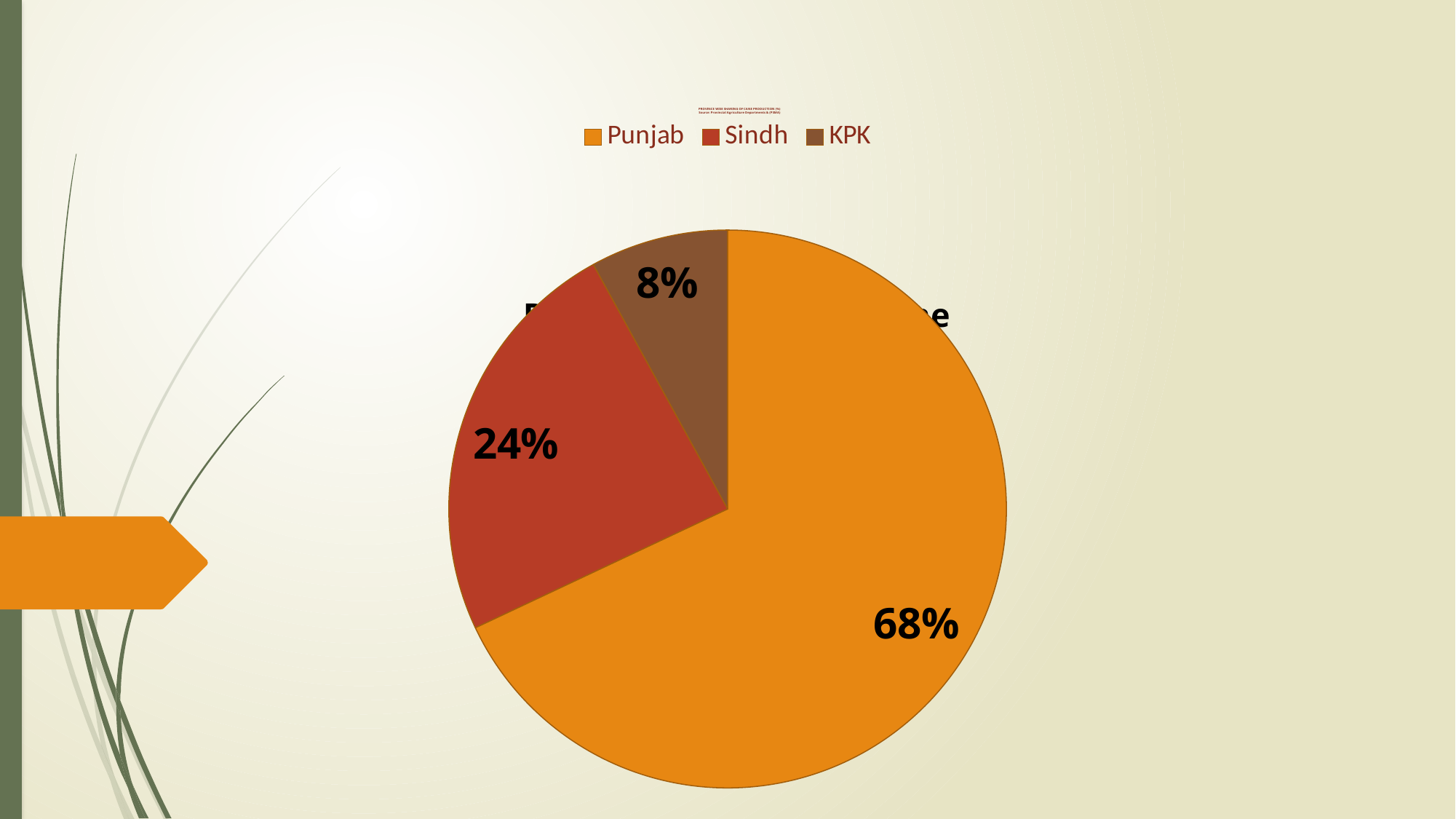
What is the difference in percentage points between Punjab's share and Sindh's share? 44 What kind of chart is shown on the slide? Pie chart How many entries does the legend list? 3 What share of the pie does KPK have? 8% What colour is the slice for Sindh? Red How many slices does the pie chart have? 3 What share of the pie does Sindh have? 24% Which is larger, the share for Sindh or the share for KPK? Sindh Which province has the smallest slice of the pie? KPK What share of the pie does Punjab have? 68% Which province has the largest slice of the pie? Punjab What is the difference in percentage points between Sindh's share and KPK's share? 16